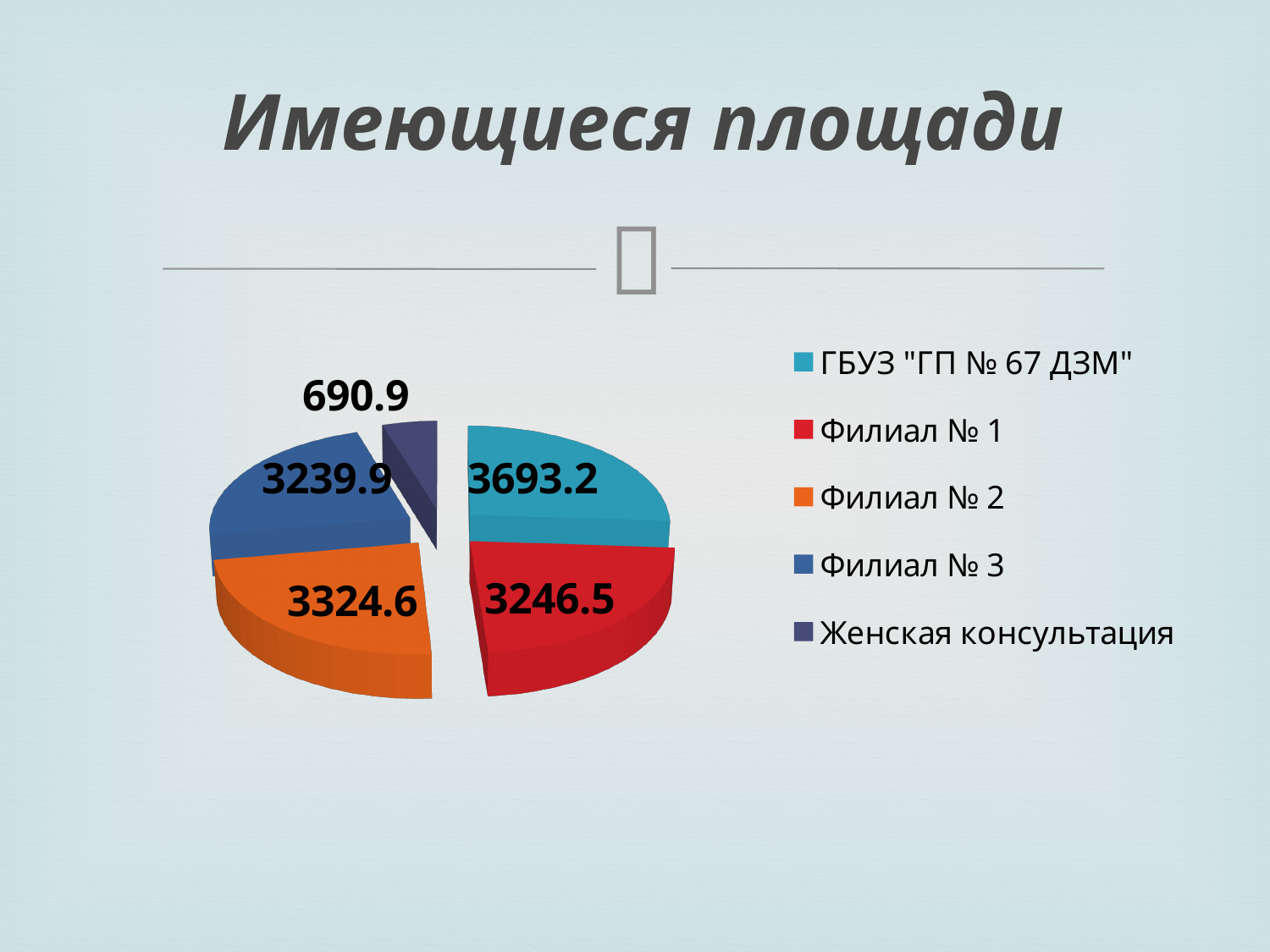
How many categories does the legend list? 5 Which category has the largest slice? ГБУЗ "ГП № 67 ДЗМ" What is the value for Филиал № 2? 3324.6 What is the value for Филиал № 3? 3239.9 What is the difference between the values for ГБУЗ "ГП № 67 ДЗМ" and Филиал № 1? 446.7 What type of chart is shown on the slide? Pie chart What is the value for Женская консультация? 690.9 What is the title of the slide? Имеющиеся площади Which category has the smallest slice? Женская консультация What is the difference between the values for Филиал № 2 and Филиал № 3? 84.7 What is the value for ГБУЗ "ГП № 67 ДЗМ"? 3693.2 Which is larger, the value for Филиал № 1 or Филиал № 3? Филиал № 1